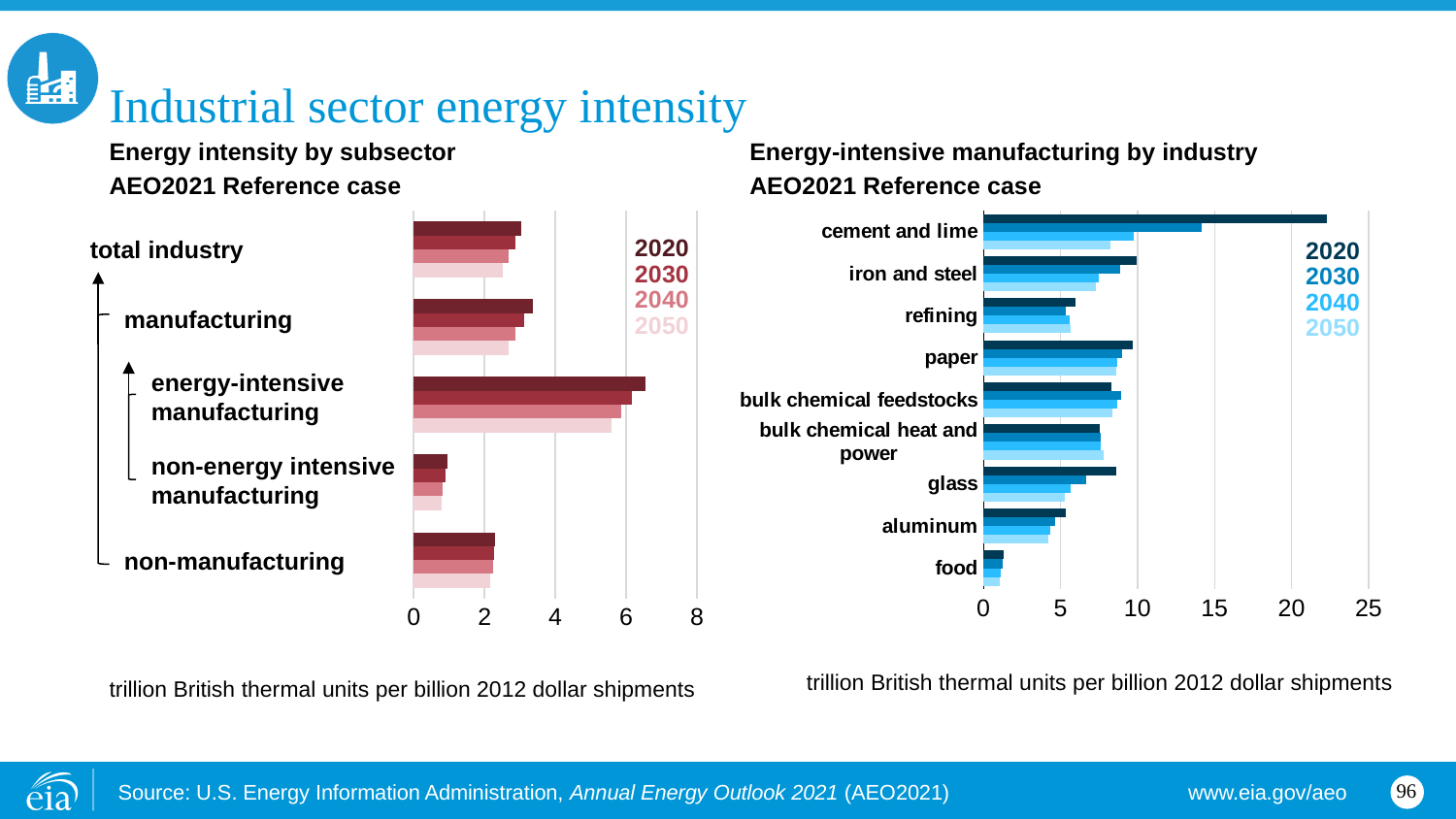
In the 'Energy-intensive manufacturing by industry' chart on the right, is the 2020 value for cement and lime greater or less than 20? greater In the 'Energy-intensive manufacturing by industry' chart on the right, which industry has the highest energy intensity in 2020? cement and lime How many series does the legend list in the 'Energy intensity by subsector' chart on the left? 4 In the 'Energy intensity by subsector' chart on the left, is the 2020 value for energy-intensive manufacturing greater or less than 6? greater In the 'Energy-intensive manufacturing by industry' chart on the right, which industry has the lowest energy intensity in 2020? food In the 'Energy intensity by subsector' chart on the left, which category has the highest energy intensity in 2020? energy-intensive manufacturing What type of chart is the 'Energy intensity by subsector' chart on the left? bar chart In the 'Energy intensity by subsector' chart on the left, which category has the lowest energy intensity in 2020? non-energy intensive manufacturing How many subsector categories are shown in the 'Energy intensity by subsector' chart on the left? 5 In the 'Energy intensity by subsector' chart on the left, which is larger in 2020: manufacturing or non-manufacturing? manufacturing How many industries are shown in the 'Energy-intensive manufacturing by industry' chart on the right? 9 In the 'Energy-intensive manufacturing by industry' chart on the right, does the energy intensity of cement and lime rise or fall from 2020 to 2050? fall